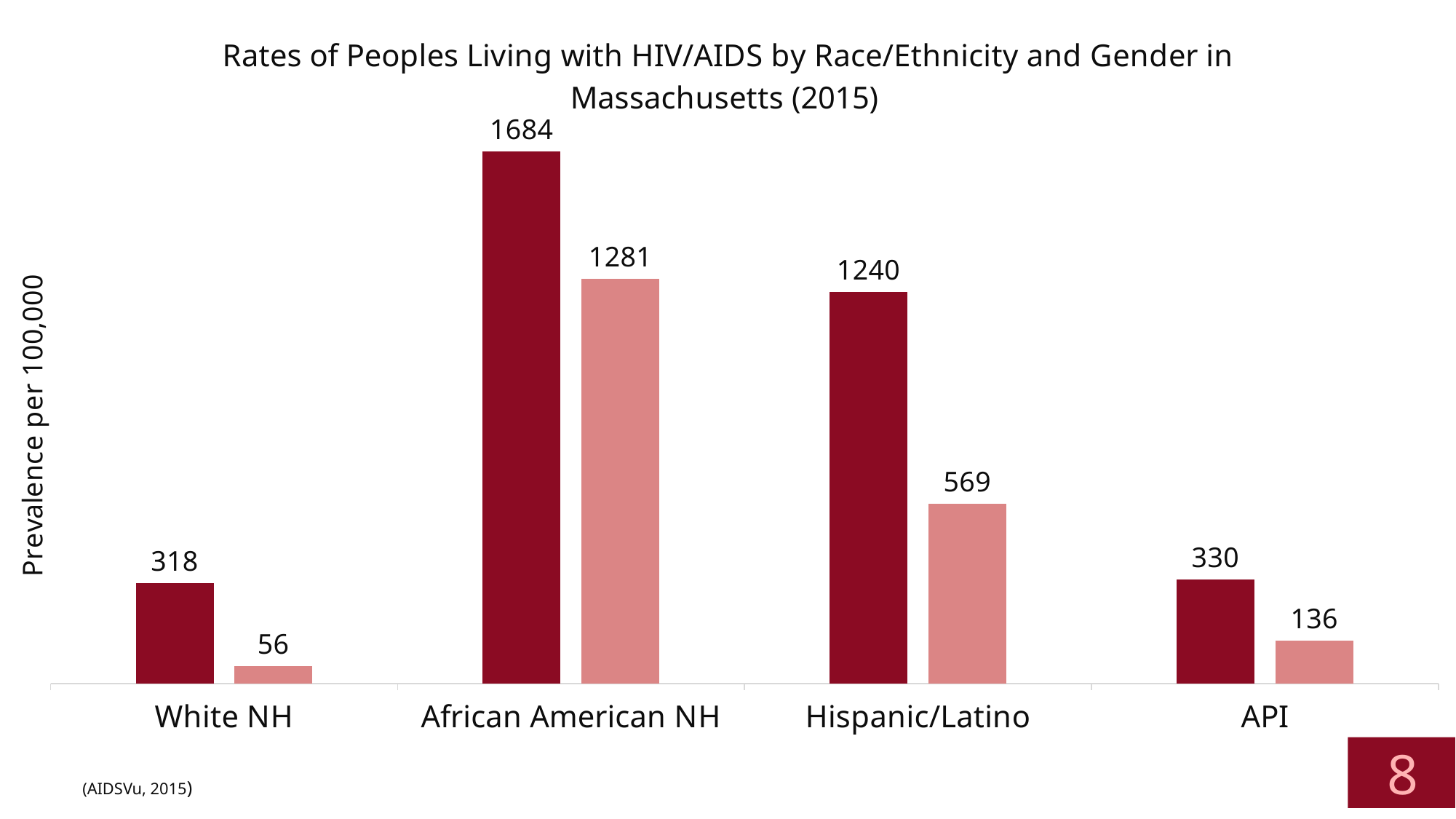
How many race/ethnicity categories are shown on the x axis? 4 What type of chart is shown on the slide? Bar chart What is the label of the vertical axis? Prevalence per 100,000 What is the value of the dark red bar for African American NH? 1684 Which is larger: the dark red bar for API or the dark red bar for White NH? API What is the difference between the dark red bar for African American NH and the dark red bar for Hispanic/Latino? 444 What is the value of the dark red bar for API? 330 What is the value of the light pink bar for Hispanic/Latino? 569 What is the difference between the dark red and light pink bars for Hispanic/Latino? 671 What is the value of the light pink bar for White NH? 56 Which race/ethnicity category has the highest dark red bar? African American NH Which race/ethnicity category has the lowest light pink bar? White NH